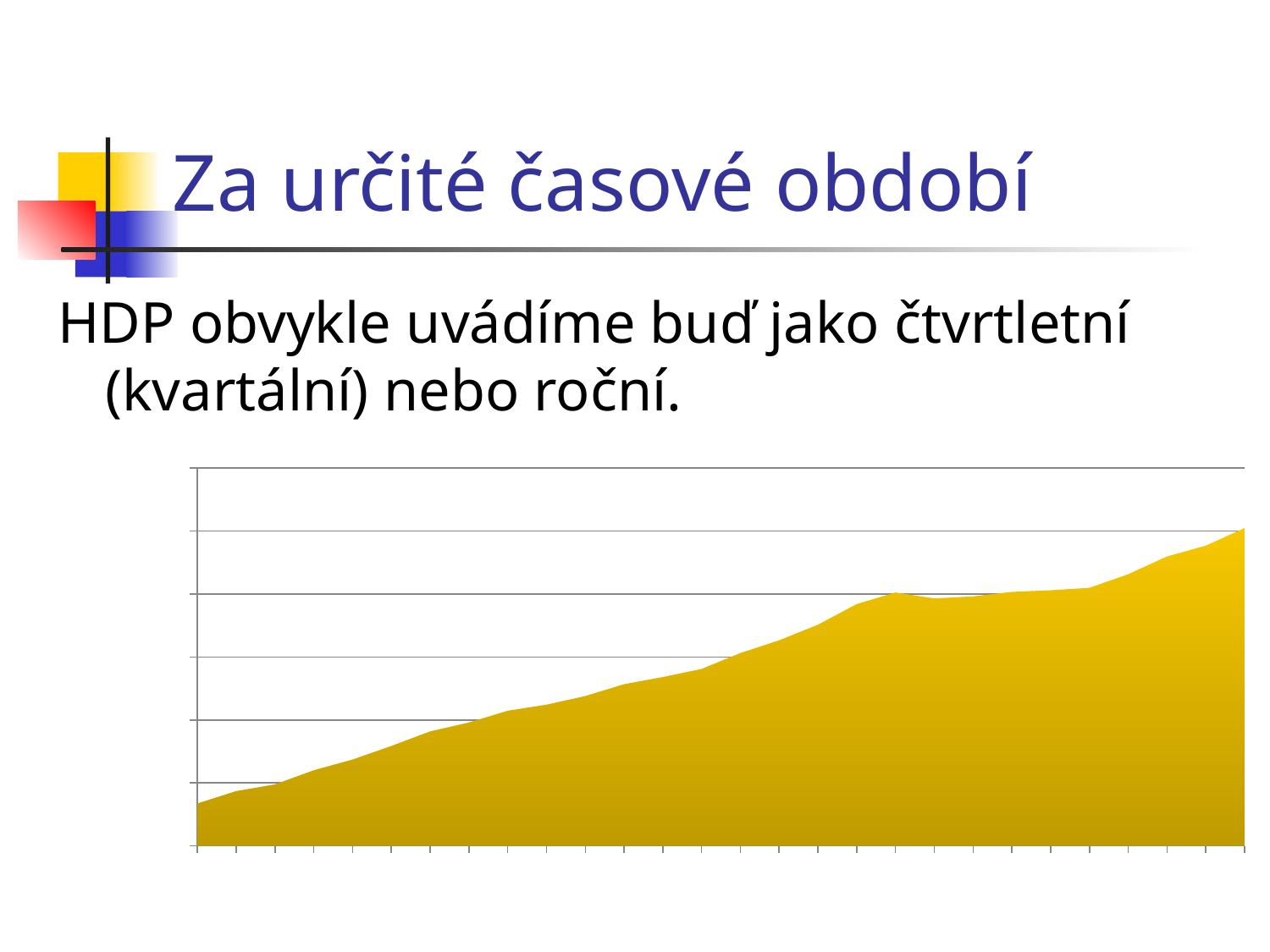
Do the values in the chart generally rise or fall from left to right along the x axis? rise Does the chart display a legend? No What kind of chart is shown on the slide? area chart What colour is the filled area in the chart? yellow